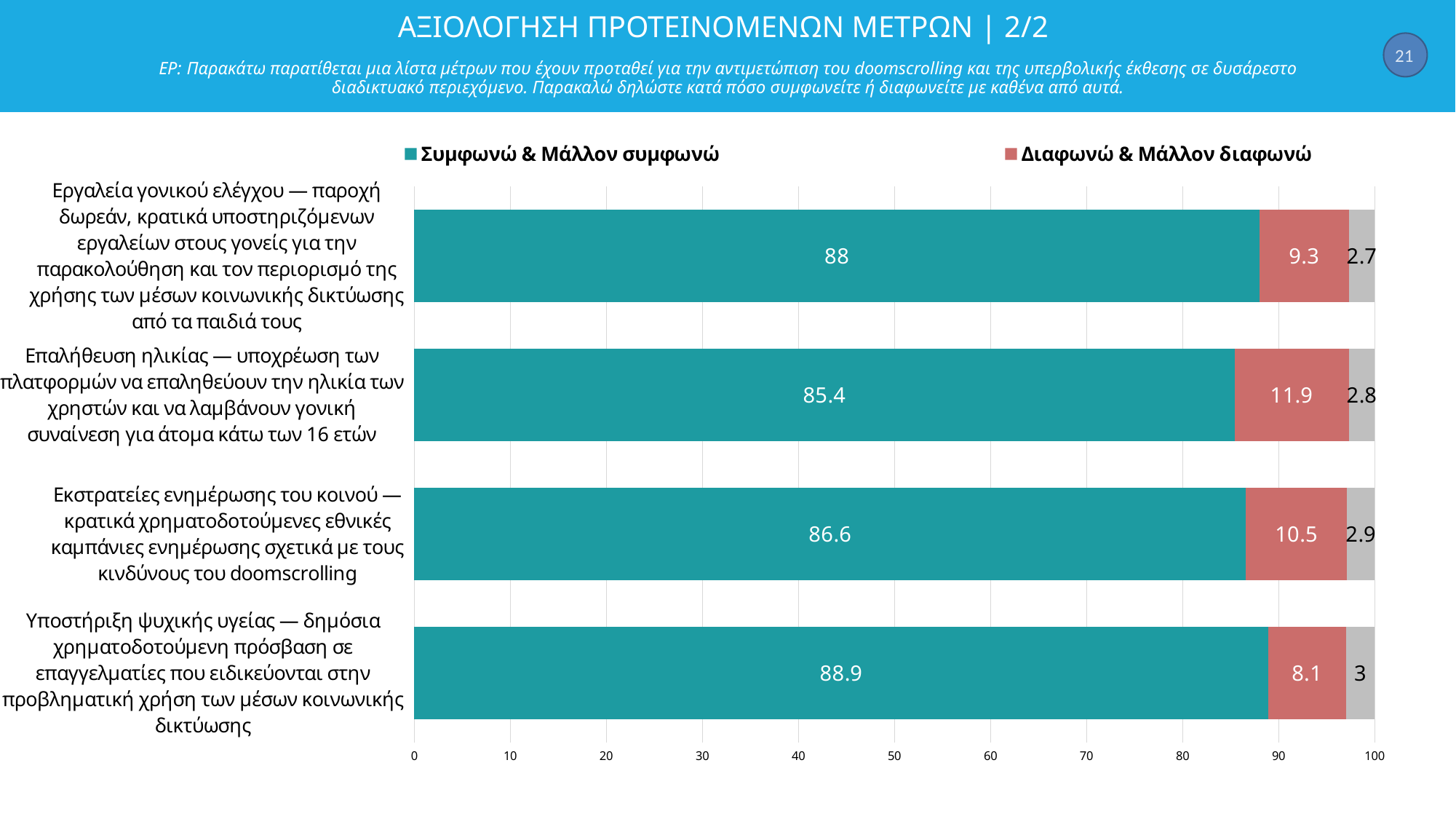
What colour represents the 'Συμφωνώ & Μάλλον συμφωνώ' series? Teal Which is larger: the 'Διαφωνώ & Μάλλον διαφωνώ' value for 'Εκστρατείες ενημέρωσης του κοινού' or for 'Υποστήριξη ψυχικής υγείας'? Εκστρατείες ενημέρωσης του κοινού How many measures (categories) are plotted in the chart? 4 What is the 'Συμφωνώ & Μάλλον συμφωνώ' value for 'Εργαλεία γονικού ελέγχου'? 88 What is the 'Διαφωνώ & Μάλλον διαφωνώ' value for 'Επαλήθευση ηλικίας'? 11.9 What is the difference between the 'Συμφωνώ & Μάλλον συμφωνώ' values for 'Υποστήριξη ψυχικής υγείας' and 'Επαλήθευση ηλικίας'? 3.5 Which measure has the lowest 'Συμφωνώ & Μάλλον συμφωνώ' value? Επαλήθευση ηλικίας What type of chart is shown on the slide? Stacked bar chart Which measure has the highest 'Συμφωνώ & Μάλλον συμφωνώ' value? Υποστήριξη ψυχικής υγείας What is the 'Συμφωνώ & Μάλλον συμφωνώ' value for 'Εκστρατείες ενημέρωσης του κοινού'? 86.6 Which measure has the highest 'Διαφωνώ & Μάλλον διαφωνώ' value? Επαλήθευση ηλικίας How many series does the legend list? 2